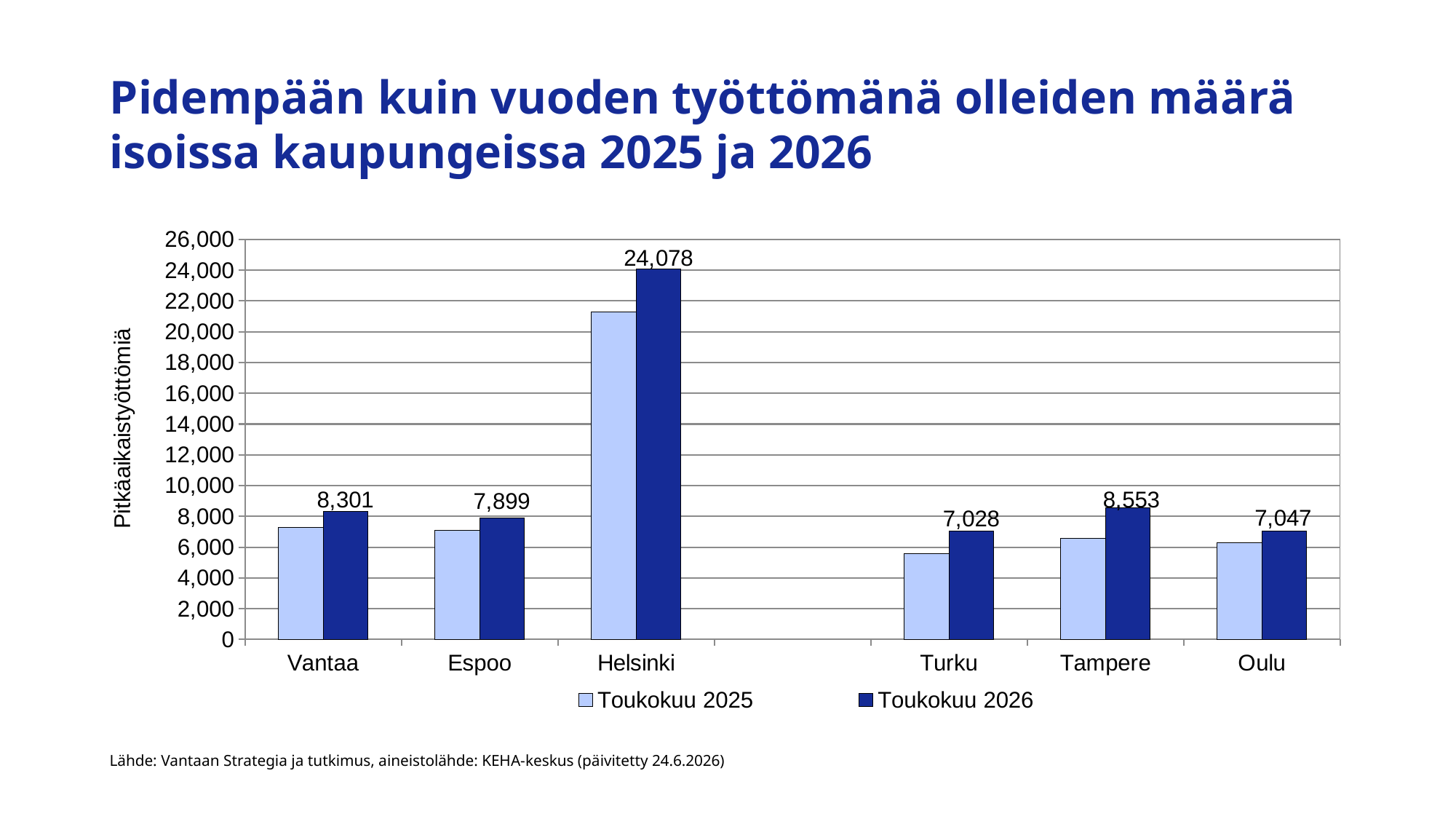
What is the value for Tampere in the Toukokuu 2026 series? 8,553 What is the value for Helsinki in the Toukokuu 2026 series? 24,078 Which city has the highest value in the Toukokuu 2026 series? Helsinki How many series does the legend list? 2 What is the difference between the Toukokuu 2026 values for Tampere and Vantaa? 252 Is the Toukokuu 2025 value for Turku greater or less than 6,000? less Which city has the lowest value in the Toukokuu 2026 series? Turku Which is larger in the Toukokuu 2026 series: Espoo or Oulu? Espoo What kind of chart is shown on the slide? Bar chart Is the Toukokuu 2025 value for Helsinki greater or less than 20,000? greater How many cities are shown on the x axis? 6 What is the value for Turku in the Toukokuu 2026 series? 7,028